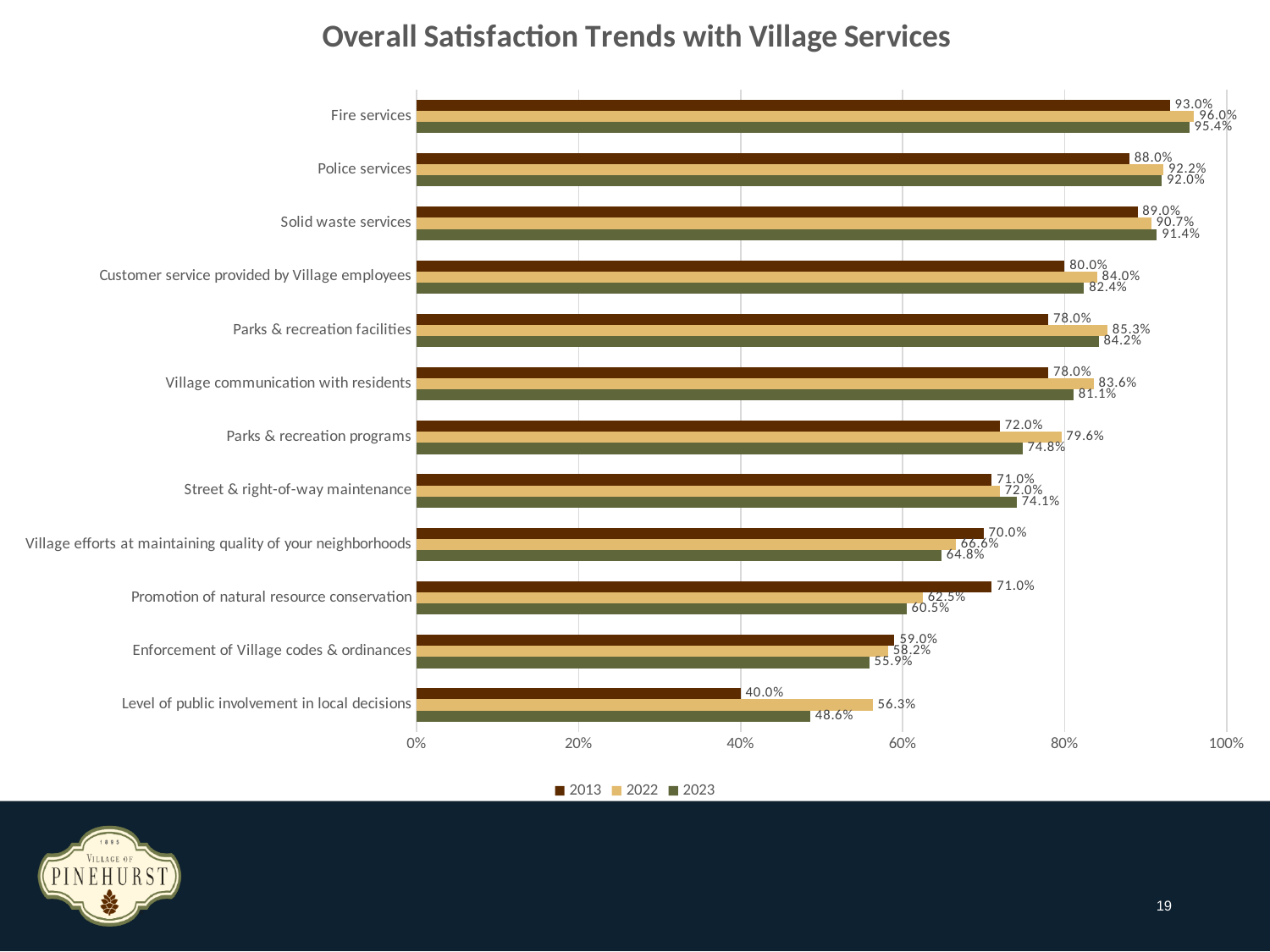
Which category has the highest 2022 value? Fire services What is the 2023 value for Fire services? 95.4% What is the 2013 value for Level of public involvement in local decisions? 40.0% What is the difference between the 2022 and 2013 values for Level of public involvement in local decisions? 16.3% What is the 2022 value for Parks & recreation programs? 79.6% Is the 2023 value for Enforcement of Village codes & ordinances greater or less than 60%? less What is the title of the chart? Overall Satisfaction Trends with Village Services How many series does the legend list? 3 Which category has the lowest 2023 value? Level of public involvement in local decisions Which is larger for Promotion of natural resource conservation: the 2013 value or the 2023 value? 2013 What kind of chart is shown on the slide? Bar chart How many service categories are shown on the chart? 12